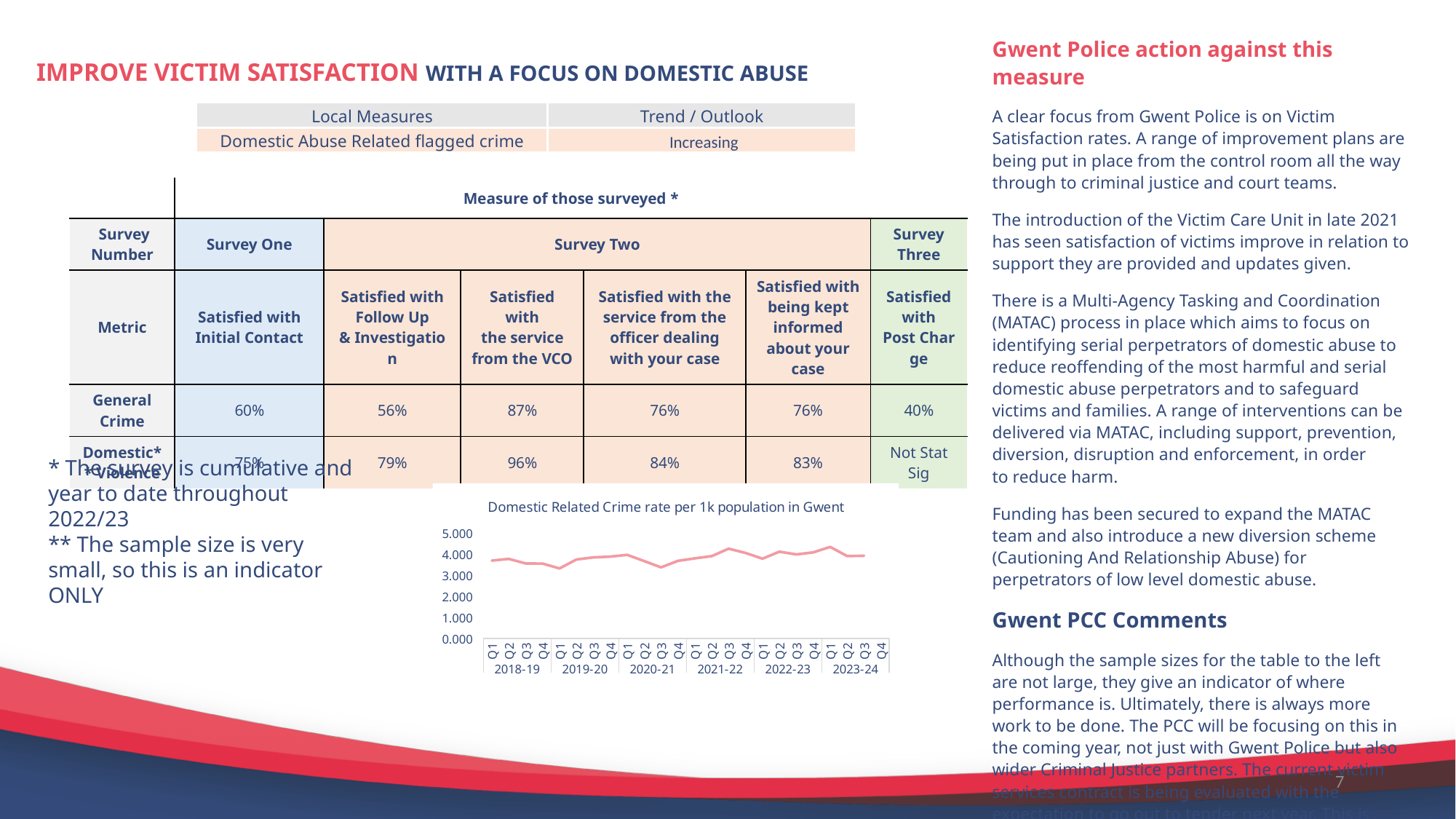
What is the highest value shown on the y axis of the chart? 5.000 Is the value for Q3 2023-24 greater or less than 5.000? less What is the first financial year labelled on the x axis of the chart? 2018-19 Is the value for Q1 2018-19 greater or less than 3.000? greater Is the value for Q1 2019-20 greater or less than 4.000? less What kind of chart is shown on the slide? Line chart Which is larger, the value for Q1 2019-20 or the value for Q1 2023-24? Q1 2023-24 How many financial years are labelled along the x axis of the chart? 6 How many lines are plotted on the chart? 1 Which quarter has the lowest domestic related crime rate on the chart? Q1 2019-20 What is the title of the chart on the slide? Domestic Related Crime rate per 1k population in Gwent